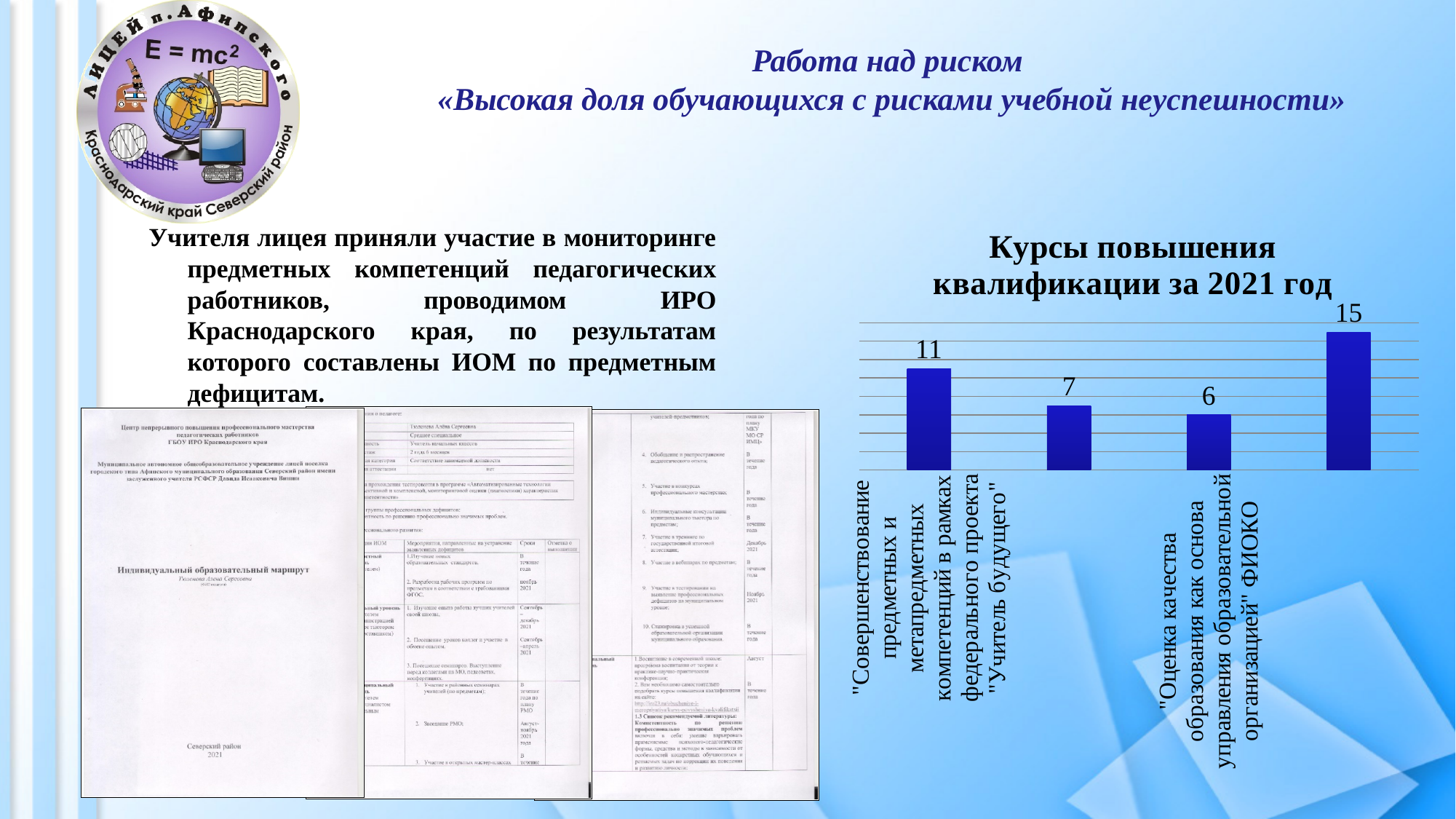
What is the highest value shown in the chart? 15 What is the title of the chart on the slide? Курсы повышения квалификации за 2021 год What is the difference between the rightmost bar and the bar for "Совершенствование предметных и метапредметных компетенций в рамках федерального проекта "Учитель будущего""? 4 What is the value of the bar labelled "Оценка качества образования как основа управления образовательной организацией" ФИОКО"? 6 How many bars are plotted in the chart? 4 What is the lowest value shown in the chart? 6 Which is larger: the value for "Совершенствование предметных и метапредметных компетенций..." or the value for "Оценка качества образования..." ФИОКО? Совершенствование предметных и метапредметных компетенций... What colour are the bars in the chart? dark blue What is the value of the rightmost bar in the chart? 15 What is the value of the bar labelled "Совершенствование предметных и метапредметных компетенций в рамках федерального проекта "Учитель будущего""? 11 What type of chart is shown on the slide? bar chart What is the value of the second bar from the left in the chart? 7